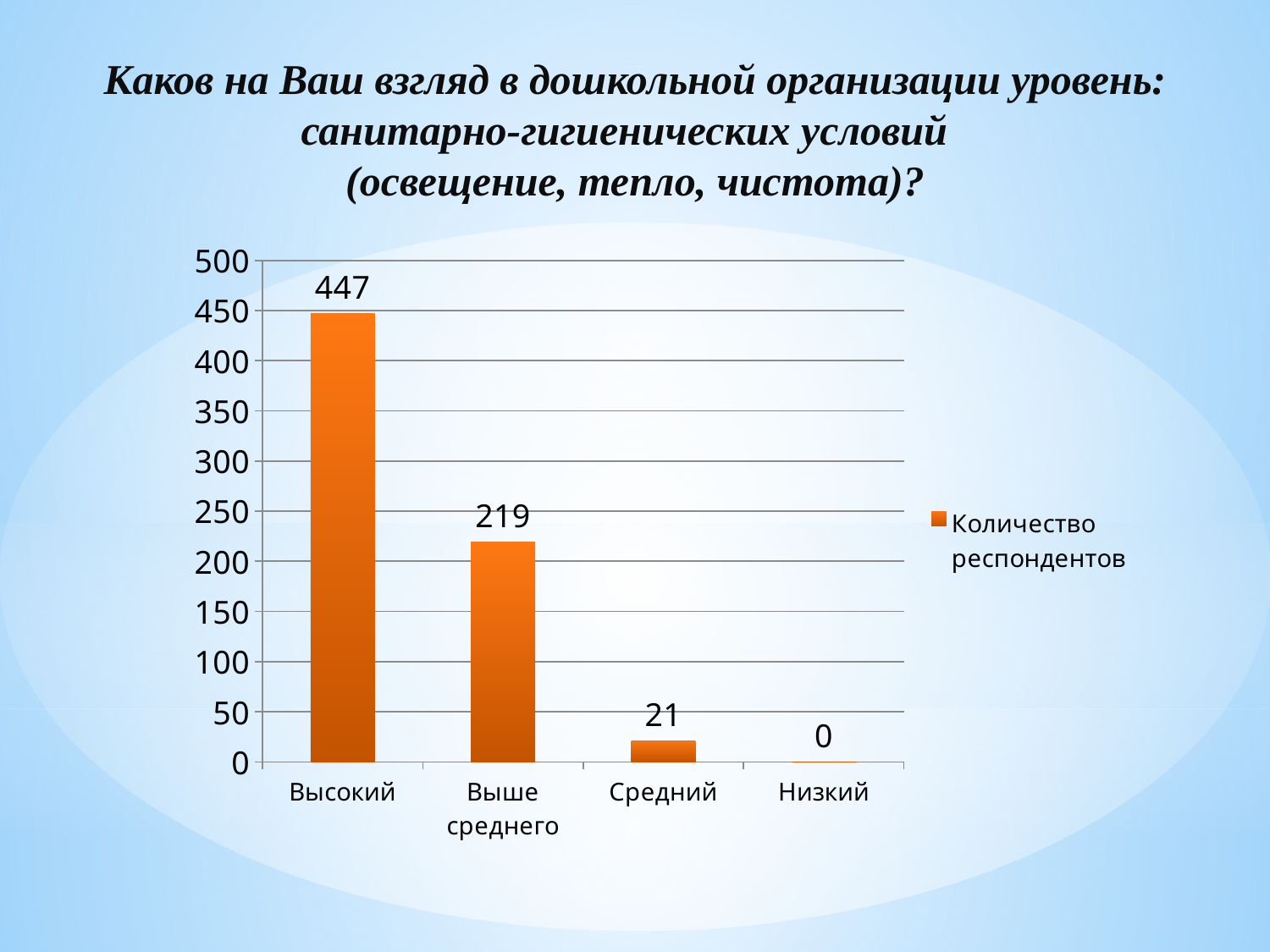
Which category has the highest value? Высокий Is the value for Выше среднего greater or less than 250? less What kind of chart is shown on the slide? bar chart What is the value for Средний? 21 How many categories are shown on the x axis? 4 What is the difference between the values for Высокий and Выше среднего? 228 What is the value for Низкий? 0 What is the value for Высокий? 447 How many series does the legend list? 1 What is the value for Выше среднего? 219 Which is larger, the value for Выше среднего or the value for Средний? Выше среднего Which category has the lowest value? Низкий